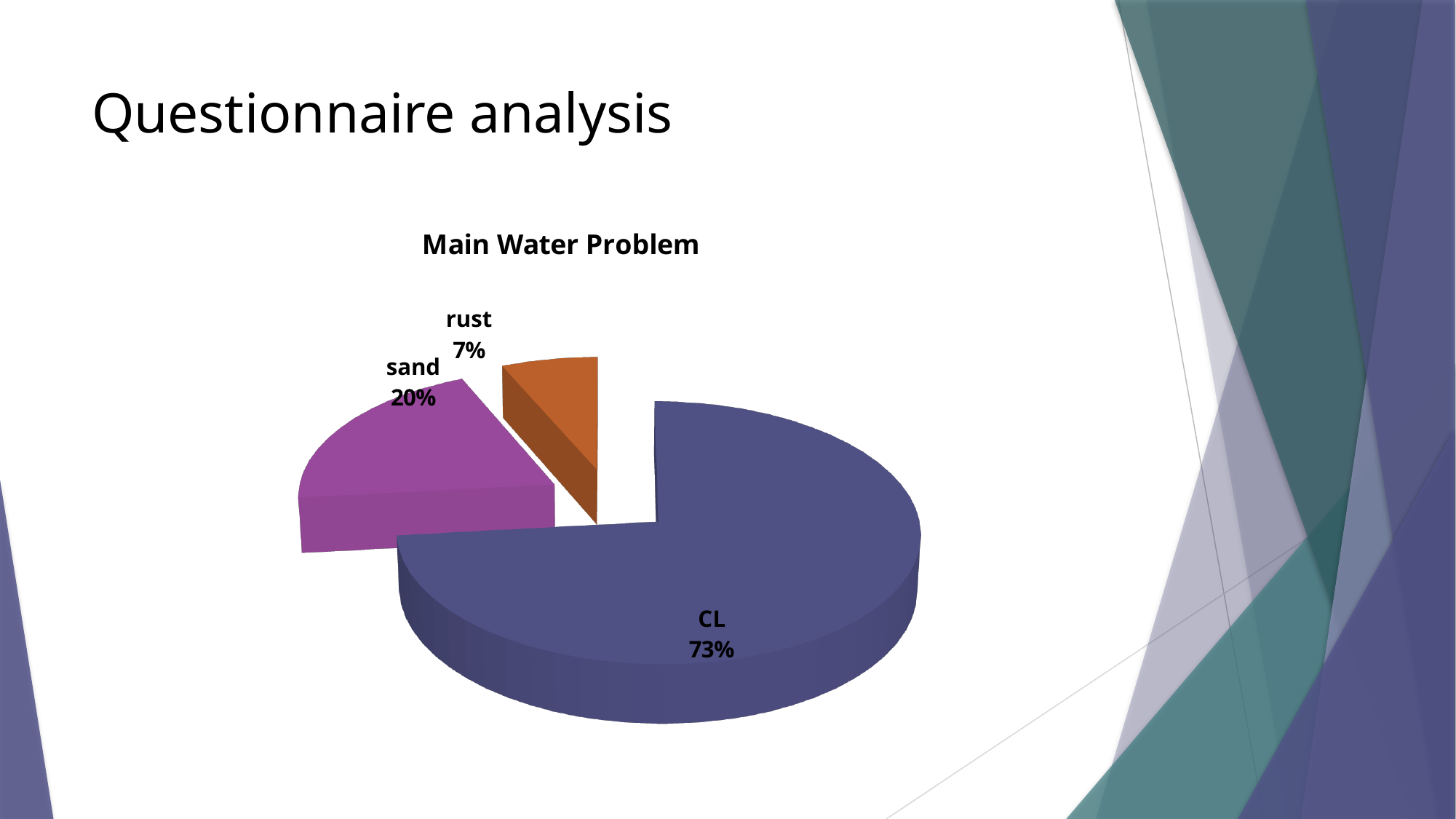
What is the difference in percentage points between the sand slice and the rust slice? 13 What kind of chart is shown on the slide? pie chart Which slice is larger, sand or rust? sand What share of the pie does rust have? 7% What share of the pie does CL have? 73% Which category has the largest slice of the pie? CL Which category has the smallest slice of the pie? rust What colour is the CL slice? dark blue What is the difference in percentage points between the CL slice and the sand slice? 53 What share of the pie does sand have? 20% How many categories are shown in the pie chart? 3 What is the title of the chart? Main Water Problem